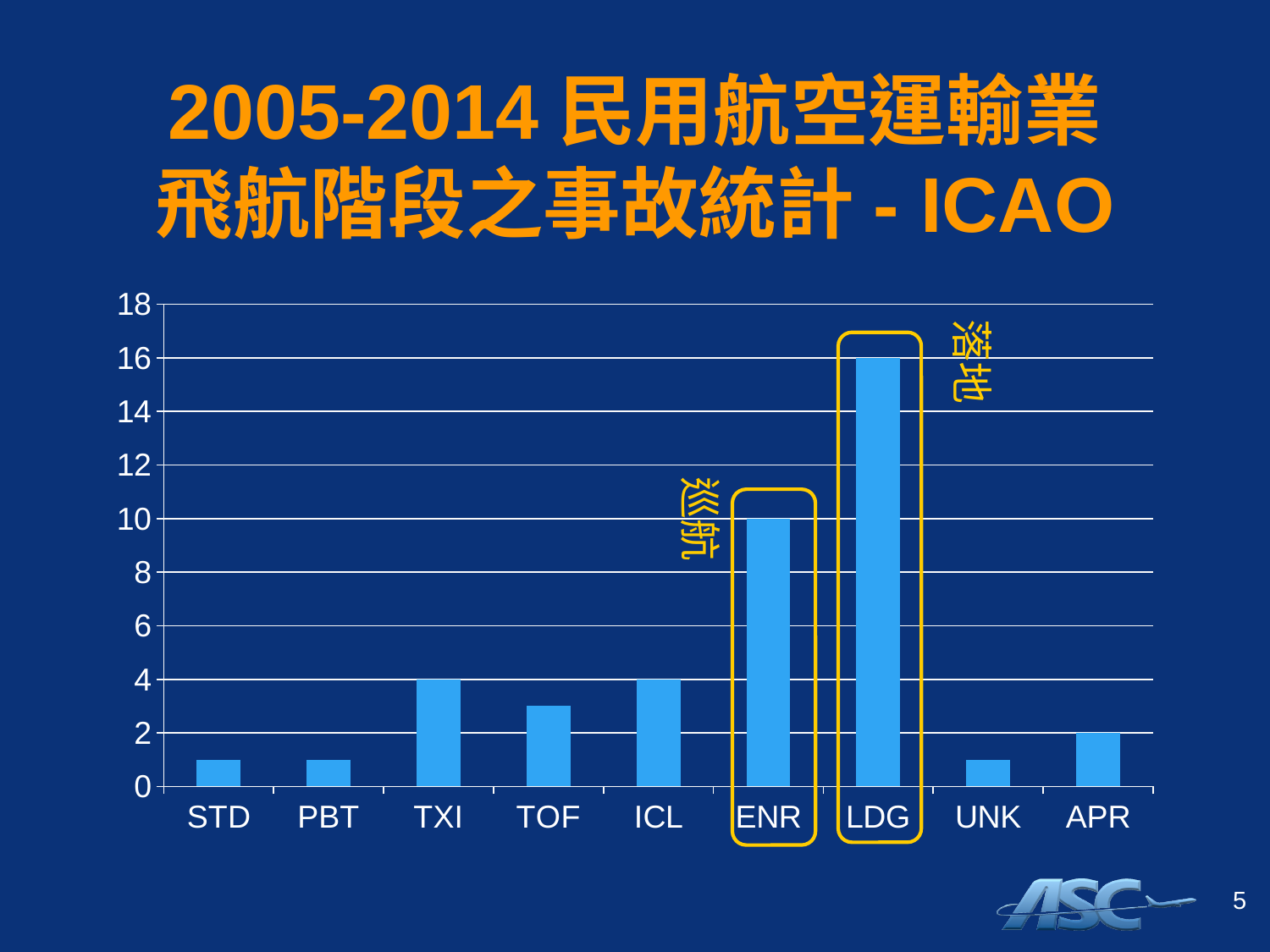
What is the value for LDG? 16 Is the value for TOF greater or less than 4? less What kind of chart is shown on the slide? bar chart Is the value for STD greater or less than 2? less What is the value for TXI? 4 How many categories are shown on the x axis of the chart? 9 Which is larger, the value for ENR or the value for ICL? ENR Which category has the highest value in the chart? LDG What is the difference between the values for LDG and ENR? 6 Which two categories are highlighted with yellow outlines on the chart? ENR and LDG What is the value for ENR? 10 What is the value for APR? 2